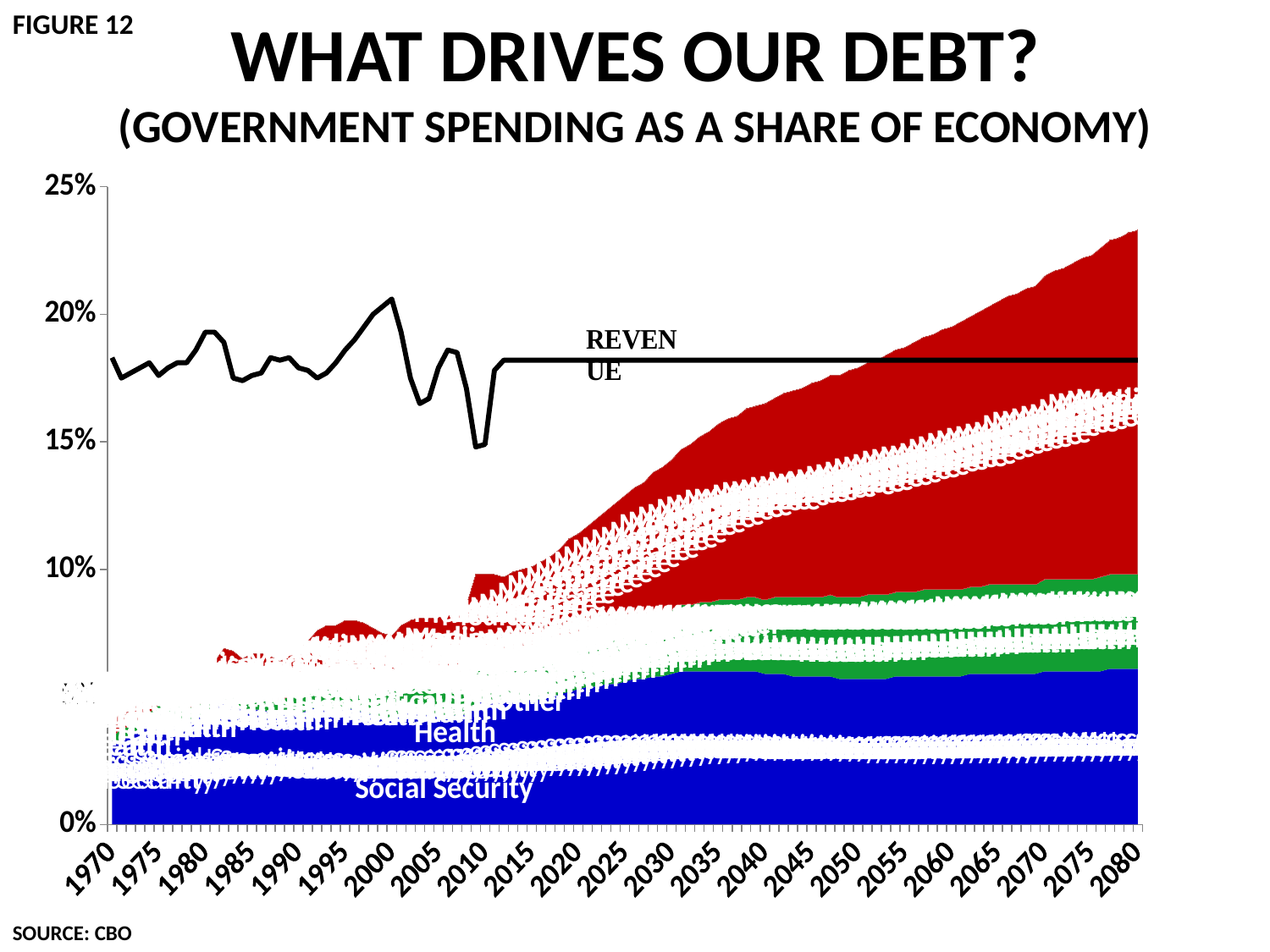
What does the black line represent? Revenue Does total government spending rise or fall between 2020 and 2080? rise Which spending category is shown in blue at the bottom of the stack? Social Security What is the source cited for the chart? CBO In 2080, which is larger: total spending or revenue? total spending Is the Social Security value in 2080 greater or less than 10%? less How many spending categories are labeled in the stacked area? 3 Is the revenue line in 2050 greater or less than 15%? greater What kind of chart is shown on the slide? Stacked area chart with a line What is the title of the chart? WHAT DRIVES OUR DEBT? (GOVERNMENT SPENDING AS A SHARE OF ECONOMY) Is the total spending value in 2080 greater or less than 20%? greater